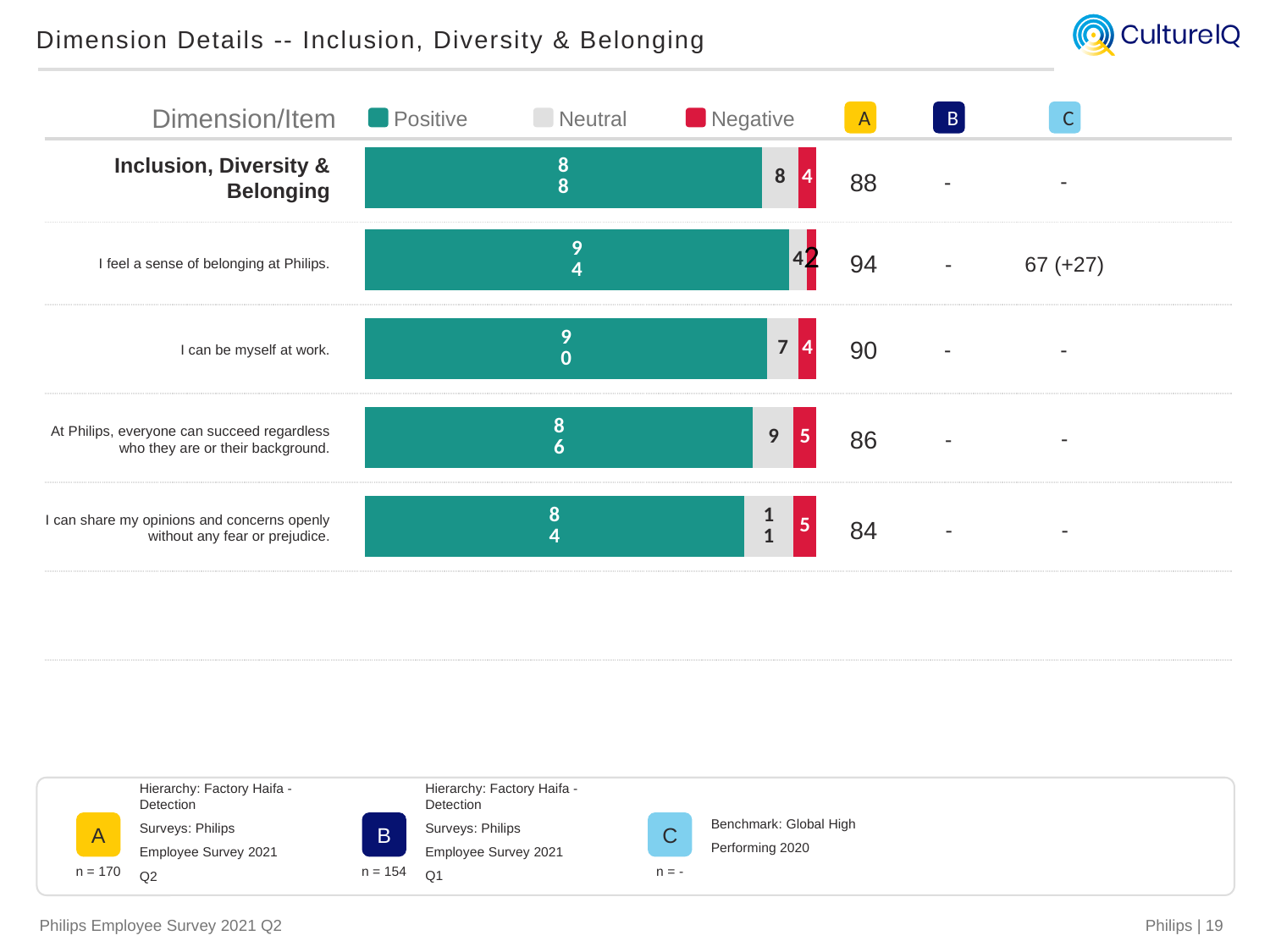
Which item has the highest Positive value? I feel a sense of belonging at Philips. How many rows (dimension/items) are plotted in the chart? 5 What is the Neutral value for "I can share my opinions and concerns openly without any fear or prejudice."? 11 What is the Negative value for "At Philips, everyone can succeed regardless who they are or their background."? 5 Which item has the lowest Positive value? I can share my opinions and concerns openly without any fear or prejudice. What is the difference between the Positive values for "I feel a sense of belonging at Philips." and "I can be myself at work."? 4 What value is shown in column C for "I feel a sense of belonging at Philips."? 67 (+27) What is the Positive value for the overall "Inclusion, Diversity & Belonging" dimension? 88 How many series does the legend list? 3 Which has a larger Neutral value: "I can be myself at work." or "At Philips, everyone can succeed regardless who they are or their background."? At Philips, everyone can succeed regardless who they are or their background. What kind of chart is shown on the slide? Stacked bar chart What is the Positive value for "I feel a sense of belonging at Philips."? 94